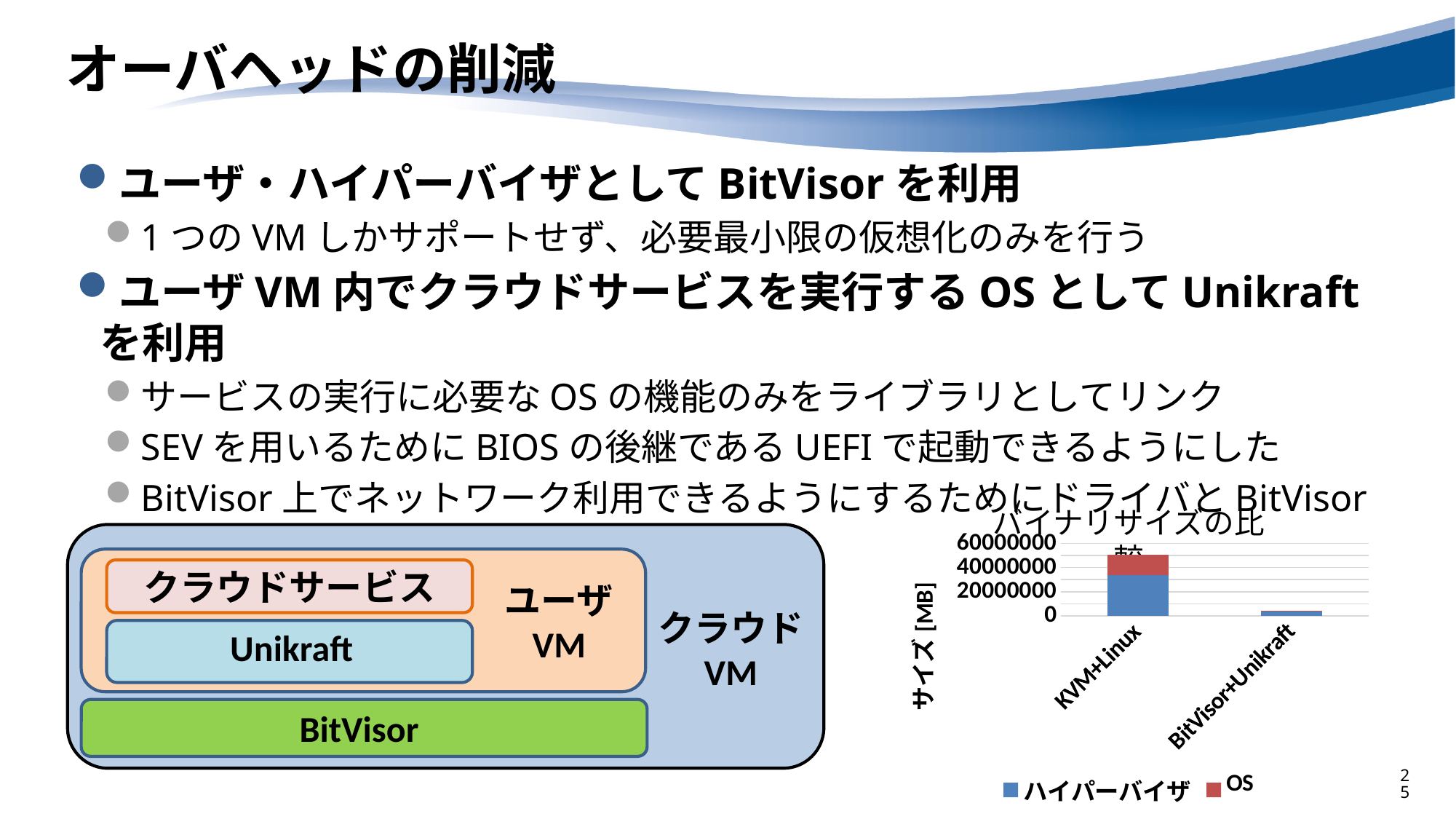
Which category has the smaller total bar in the chart? BitVisor+Unikraft What kind of chart is shown on the slide? bar chart How many categories are shown on the x axis of the chart? 2 What is the label of the chart's y axis? サイズ [MB] Which category has the larger total bar in the chart? KVM+Linux Is the ハイパーバイザ portion of the KVM+Linux bar greater or less than 20000000? greater Which is larger for KVM+Linux: the ハイパーバイザ portion or the OS portion? ハイパーバイザ Is the total bar for BitVisor+Unikraft greater or less than 20000000? less What are the two series listed in the chart's legend? ハイパーバイザ and OS Is the total bar for KVM+Linux greater or less than 40000000? greater How many series does the chart's legend list? 2